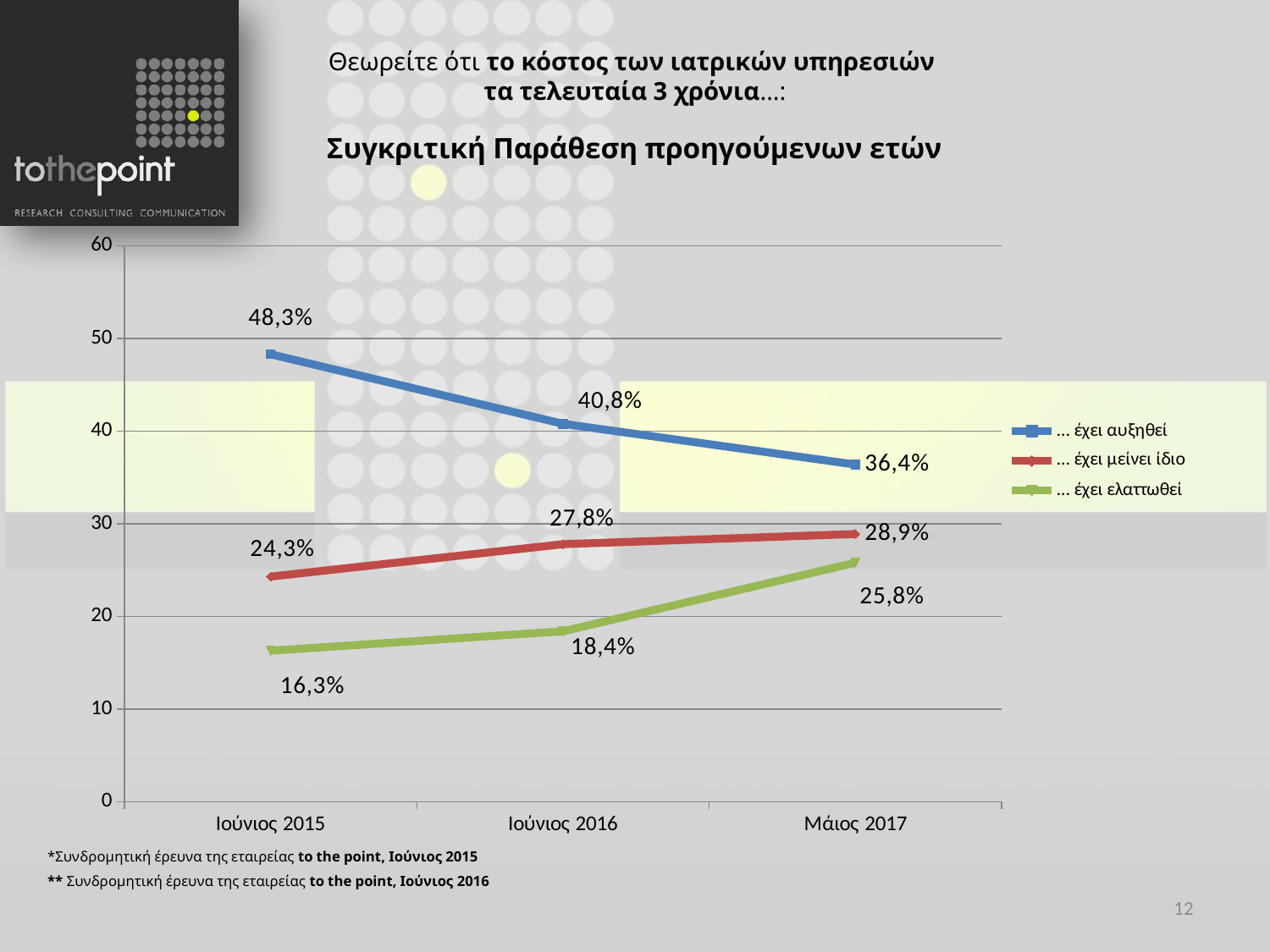
What is the value for "... έχει ελαττωθεί" in Μάιος 2017? 25,8% Which is larger in Μάιος 2017: "... έχει μείνει ίδιο" or "... έχει ελαττωθεί"? ... έχει μείνει ίδιο How many time points are shown on the x axis? 3 In which time point is the value for "... έχει ελαττωθεί" highest? Μάιος 2017 What kind of chart is shown on the slide? line chart What is the value for "... έχει αυξηθεί" in Ιούνιος 2015? 48,3% What is the difference between the "... έχει αυξηθεί" values in Ιούνιος 2015 and Μάιος 2017? 11,9% Which colour is used for the "... έχει ελαττωθεί" series? green How many series does the legend list? 3 Does the value for "... έχει αυξηθεί" rise or fall from Ιούνιος 2015 to Μάιος 2017? fall In which time point is the value for "... έχει αυξηθεί" lowest? Μάιος 2017 What is the value for "... έχει μείνει ίδιο" in Ιούνιος 2016? 27,8%